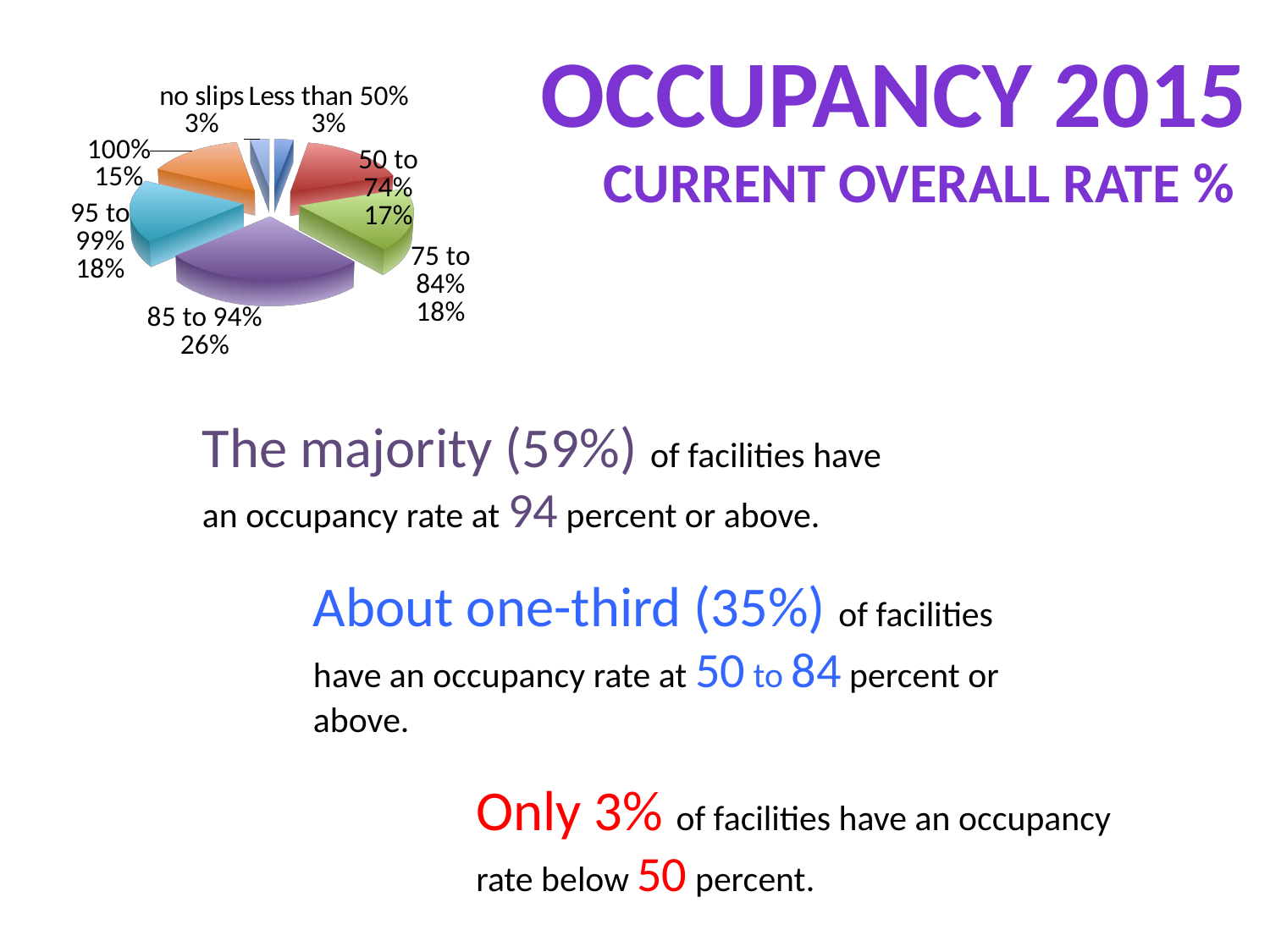
Which occupancy category has the largest slice of the pie? 85 to 94% How many slices does the pie chart have? 7 What share of facilities have an occupancy rate of 50 to 74%? 17% What share of facilities have an occupancy rate of less than 50%? 3% What kind of chart is shown on the slide? pie chart What share of facilities are labelled 'no slips'? 3% What share of facilities have an occupancy rate of 85 to 94%? 26% Which slice is larger: 100% or 50 to 74%? 50 to 74% What is the title shown on the slide above the chart's description? OCCUPANCY 2015 CURRENT OVERALL RATE % Which slice is larger: 85 to 94% or 95 to 99%? 85 to 94% What is the difference in percentage points between the 85 to 94% slice and the 50 to 74% slice? 9 What share of facilities have an occupancy rate of 100%? 15%